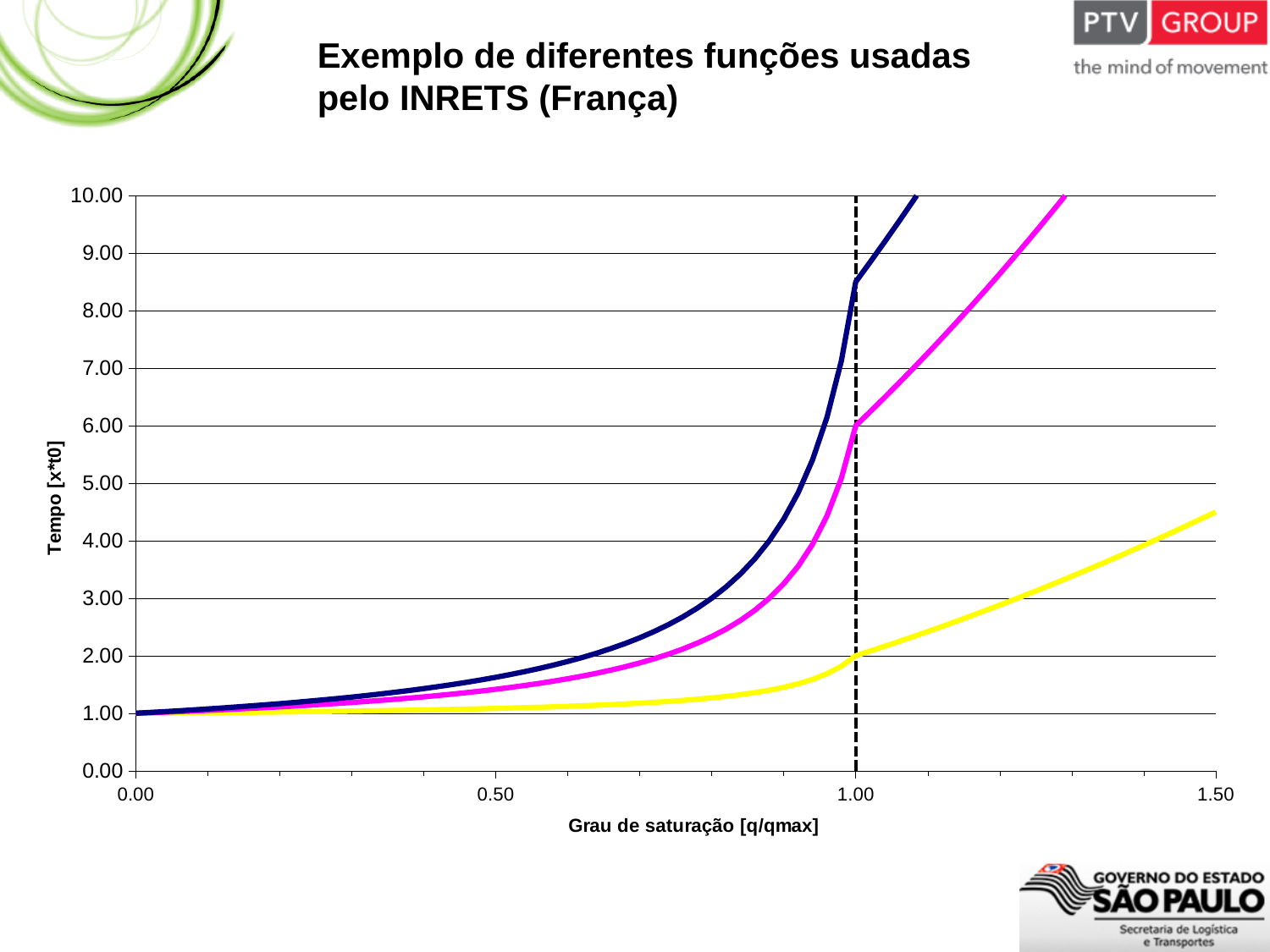
What kind of chart is shown on the slide? line chart What is the title of the chart's x axis? Grau de saturação [q/qmax] At a saturation of 0.50, which curve is higher: the dark blue or the yellow one? dark blue Do the curves rise or fall as the degree of saturation increases along the x axis? rise Which curve has the lowest value at a saturation of 1.00: the dark blue, the magenta or the yellow one? yellow Is the value of the yellow curve at a saturation of 1.50 greater or less than 4.00? greater How many curves are plotted on the chart? 3 Is the value of the magenta curve at a saturation of 0.50 greater or less than 2.00? less Is the value of the dark blue curve at a saturation of 1.00 greater or less than 8.00? greater At what x-axis value is the dashed vertical line drawn? 1.00 What is the title of the chart's y axis? Tempo [x*t0] Which curve has the highest value at a saturation of 0.80: the dark blue, the magenta or the yellow one? dark blue